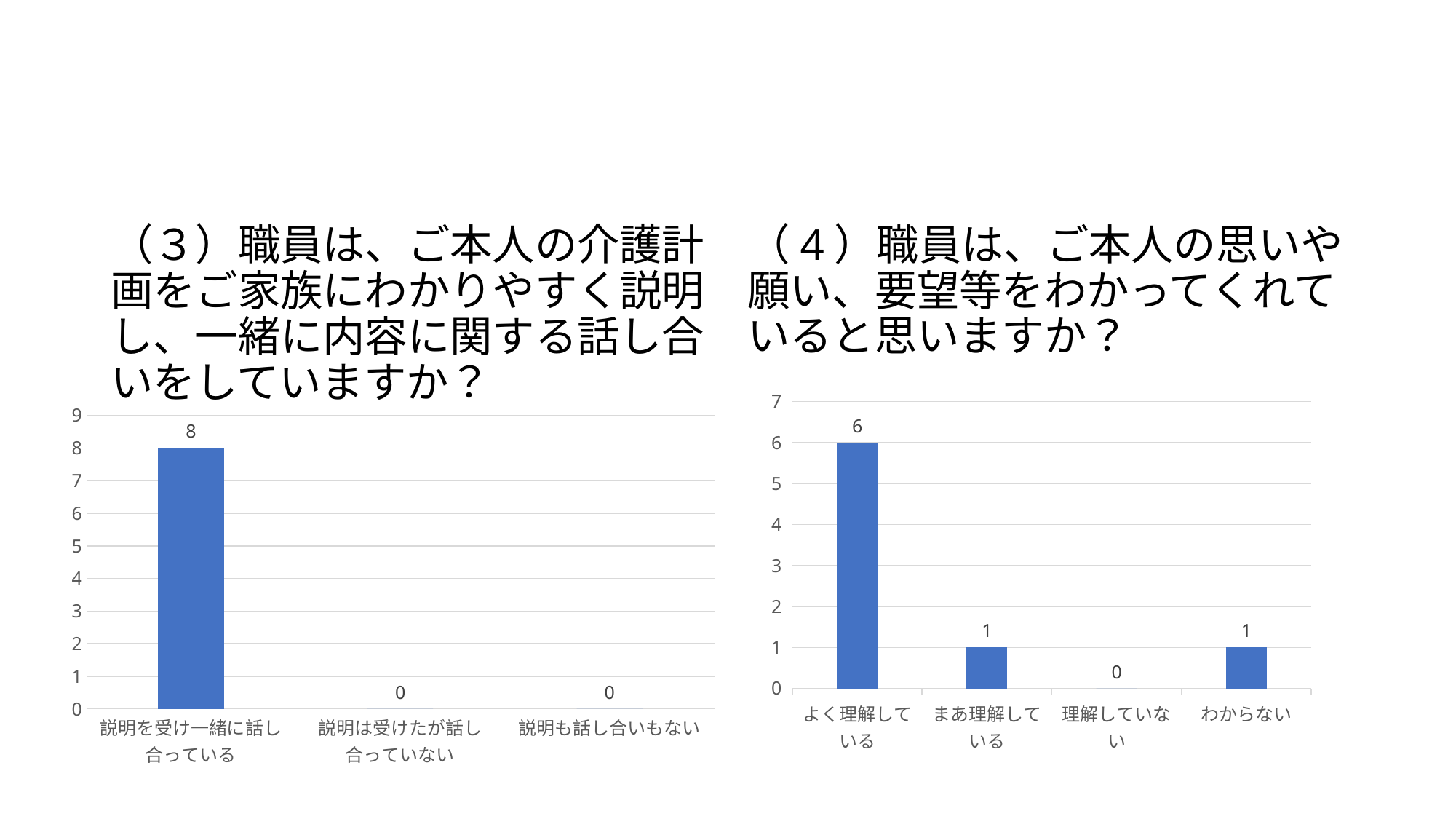
In the right chart (question (4)), what is the difference between the values for よく理解している and まあ理解している? 5 In the right chart (question (4)), what is the value for わからない? 1 In the left chart (question (3)), how many categories are shown on the x axis? 3 In the left chart (question (3)), what is the value for 説明を受け一緒に話し合っている? 8 In the left chart (question (3)), what is the total of all the bar values? 8 In the right chart (question (4)), what is the value for 理解していない? 0 In the left chart (question (3)), what is the value for 説明は受けたが話し合っていない? 0 In the right chart (question (4)), what is the value for よく理解している? 6 In the left chart (question (3)), which category has the highest value? 説明を受け一緒に話し合っている What kind of chart is the right chart (question (4))? bar chart In the right chart (question (4)), how many categories are shown on the x axis? 4 In the right chart (question (4)), which is larger, the value for よく理解している or the value for わからない? よく理解している